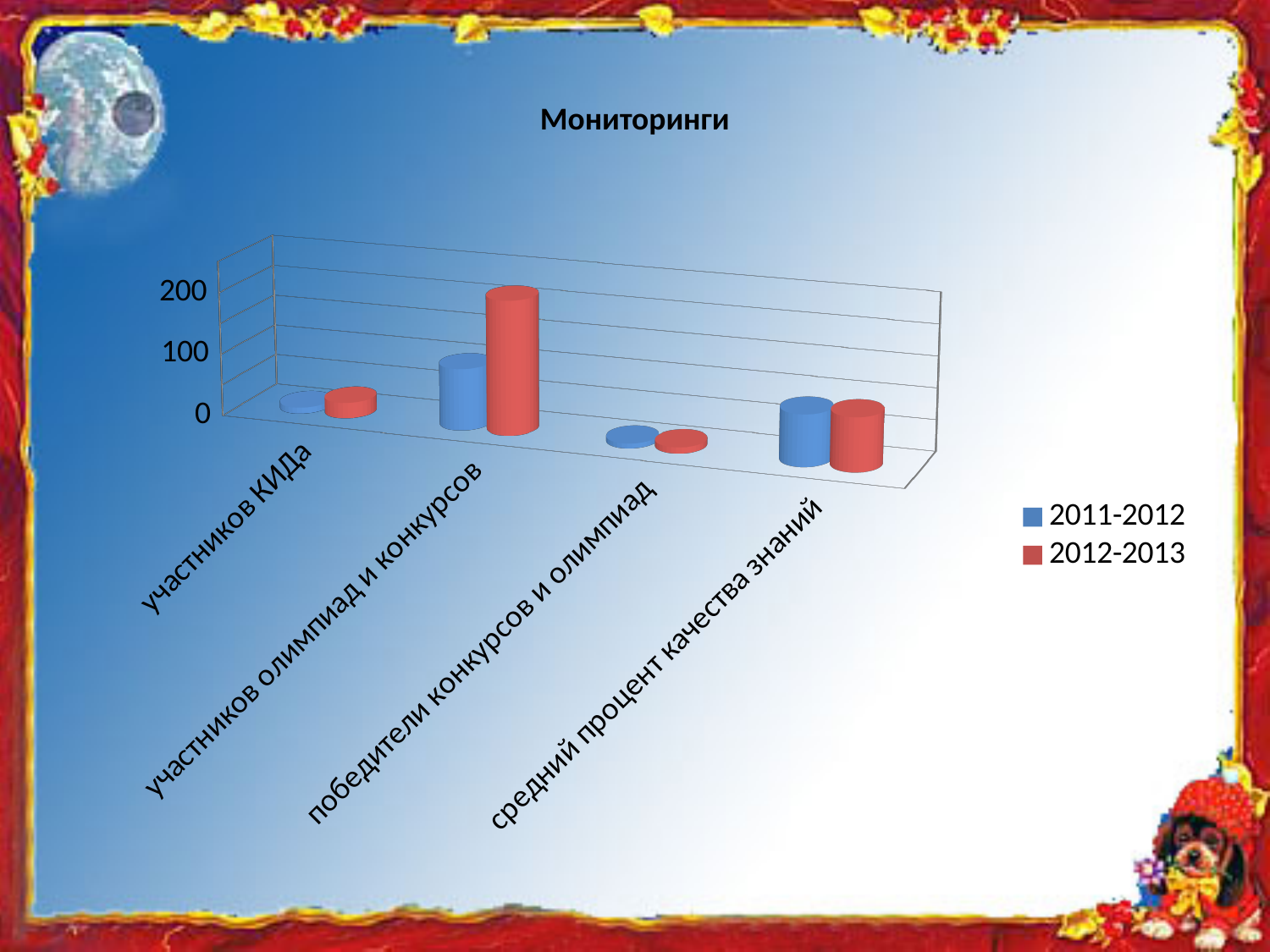
Which series is shown in red in the chart? 2012-2013 How many categories are shown on the x axis of the chart? 4 For the category 'участников олимпиад и конкурсов', which series has the larger value, 2011-2012 or 2012-2013? 2012-2013 Is the 2012-2013 value for 'участников олимпиад и конкурсов' greater or less than 100? greater Which category has the highest value for the 2012-2013 series? участников олимпиад и конкурсов Is the 2011-2012 value for 'средний процент качества знаний' greater or less than 100? less What is the title of the chart? Мониторинги Is the 2012-2013 value for 'победители конкурсов и олимпиад' greater or less than 100? less What kind of chart is shown on the slide? bar chart How many series does the legend list? 2 For the category 'участников КИДа', which series has the larger value, 2011-2012 or 2012-2013? 2012-2013